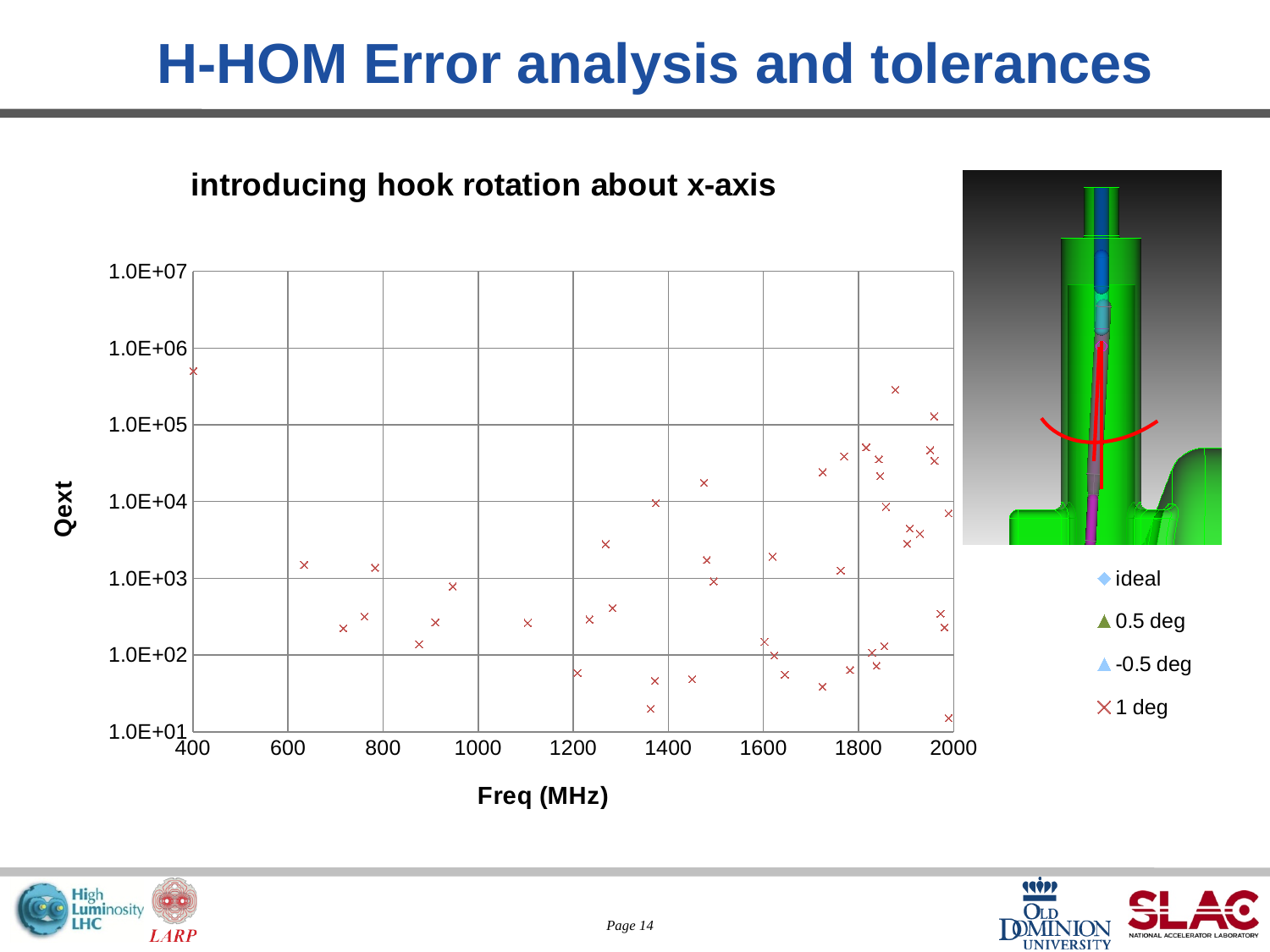
What is the label of the x axis of the chart? Freq (MHz) Is the Qext value of the point plotted near 1100 MHz greater or less than 1.0E+03? less Is the Qext value of the point plotted near 1100 MHz greater or less than 1.0E+02? greater Is the Qext value of the lowest point near 2000 MHz greater or less than 1.0E+02? less What kind of chart is shown on the slide? scatter chart What is the title of the chart? introducing hook rotation about x-axis How many series does the chart legend list? 4 Which legend series is plotted with x-shaped markers? 1 deg